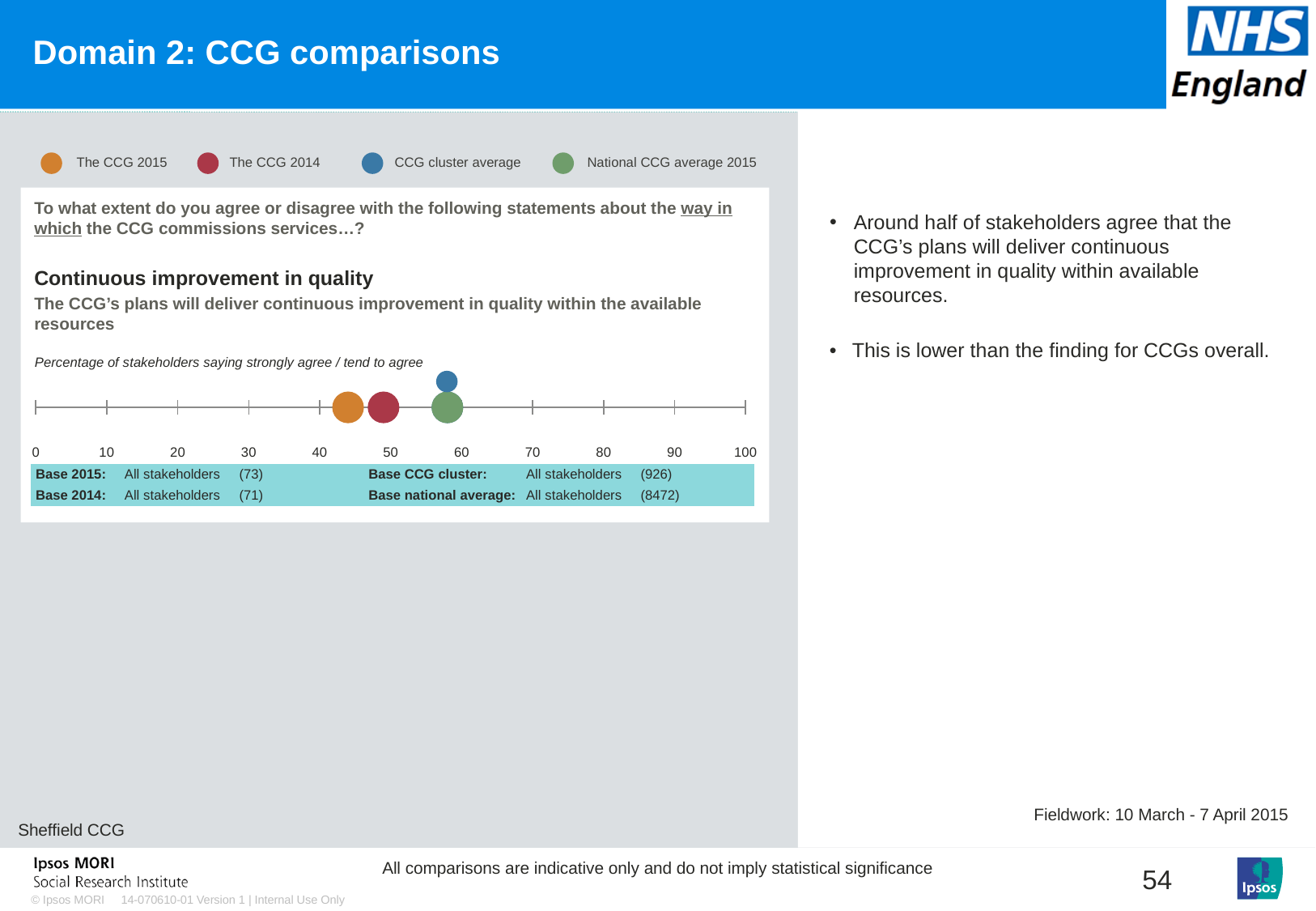
What colour marker represents The CCG 2015 in the legend? Orange Which is larger, the value for The CCG 2015 or the National CCG average 2015? National CCG average 2015 What kind of chart is shown on the slide? Dot plot Is the value for the CCG cluster average greater or less than 50? greater How many data points are plotted on the axis? 4 Which series has the lowest value on the chart? The CCG 2015 Is the value for the National CCG average 2015 greater or less than 70? less Which is larger, the value for The CCG 2015 or The CCG 2014? The CCG 2014 Is the value for The CCG 2015 greater or less than 40? greater How many series does the legend list? 4